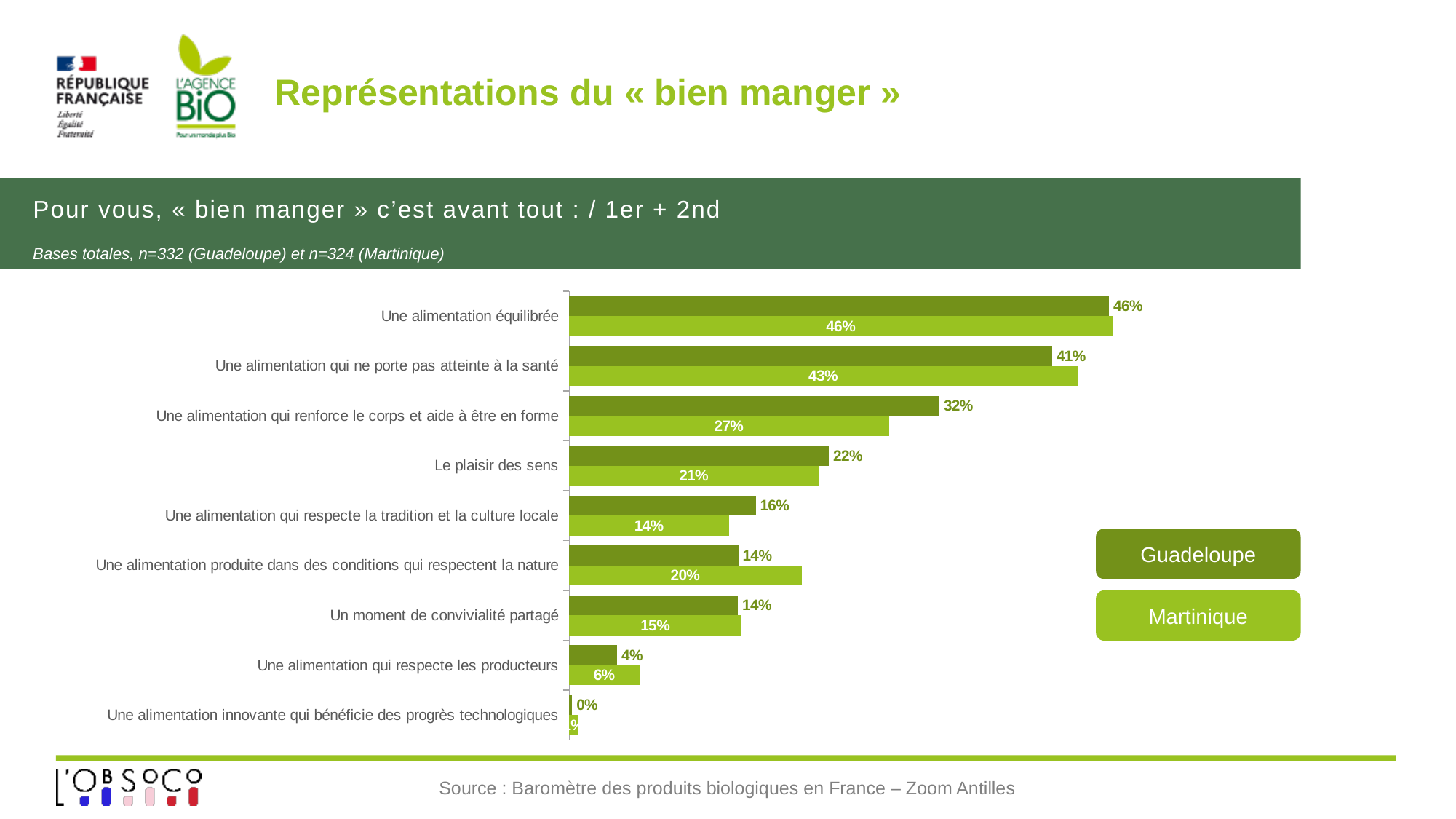
Which category has the highest Guadeloupe value? Une alimentation équilibrée Which series is shown in the darker green colour? Guadeloupe Which category has the lowest Guadeloupe value? Une alimentation innovante qui bénéficie des progrès technologiques How many series does the legend list? 2 What is the Martinique value for "Une alimentation produite dans des conditions qui respectent la nature"? 20% How many categories are shown in the chart? 9 What is the difference between the Guadeloupe and Martinique values for "Une alimentation qui renforce le corps et aide à être en forme"? 5% What is the Martinique value for "Une alimentation qui ne porte pas atteinte à la santé"? 43% What kind of chart is shown on the slide? Bar chart What is the Guadeloupe value for "Une alimentation qui renforce le corps et aide à être en forme"? 32% For "Une alimentation produite dans des conditions qui respectent la nature", which is larger: the Guadeloupe value or the Martinique value? Martinique What is the Guadeloupe value for "Une alimentation qui respecte les producteurs"? 4%